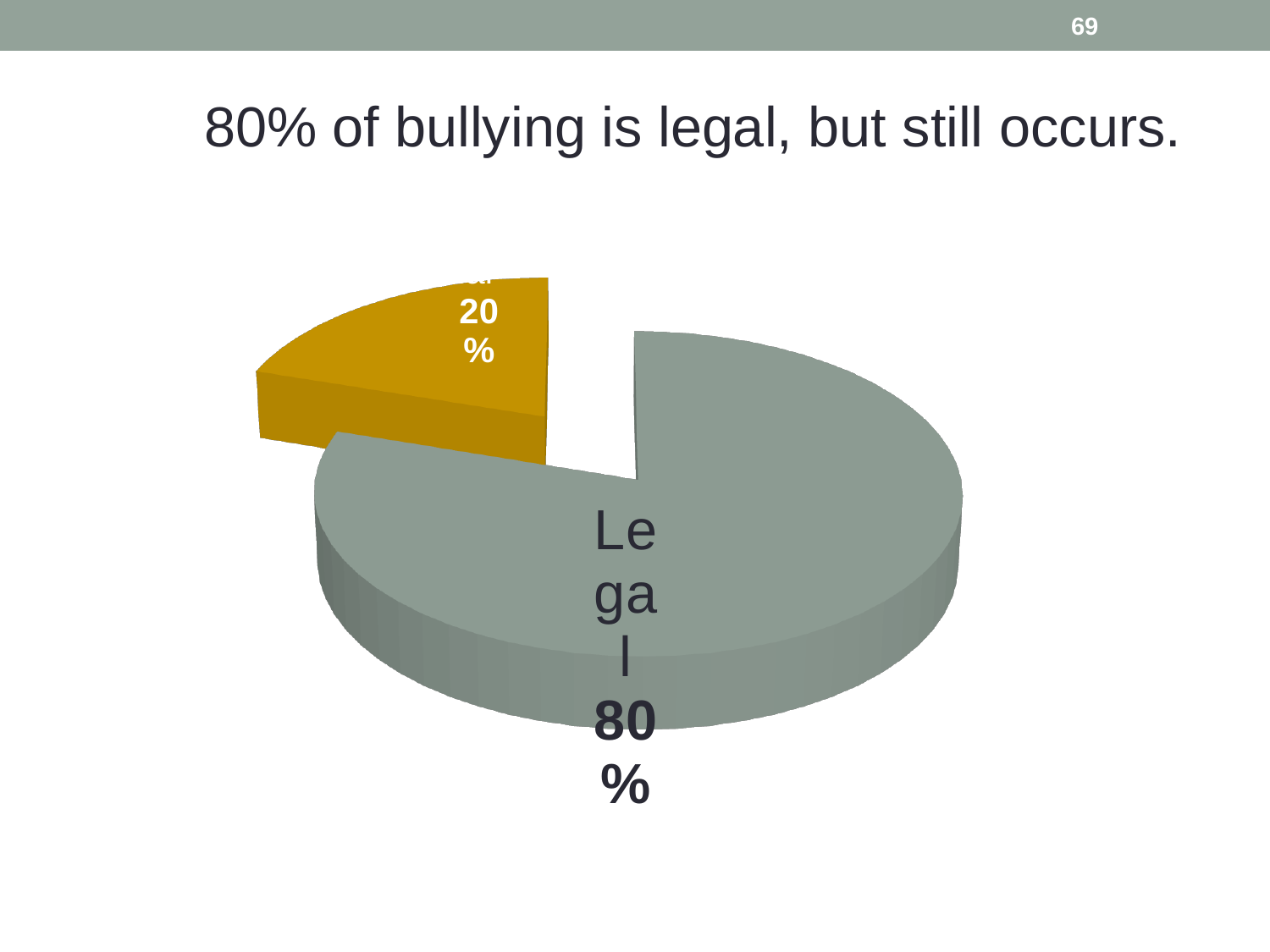
What kind of chart is shown on the slide? pie chart What is the title of the slide containing the pie chart? 80% of bullying is legal, but still occurs. What colour is the Legal slice of the pie chart? grey What percentage does the gold (exploded) slice of the pie chart show? 20% How many slices does the pie chart have? 2 What share of the pie does the Legal slice represent? 80% What is the difference in percentage points between the Legal slice and the gold slice? 60 Which slice of the pie chart is the largest? Legal What percentage does the Legal slice of the pie chart show? 80% Which is larger, the Legal slice or the gold slice? Legal